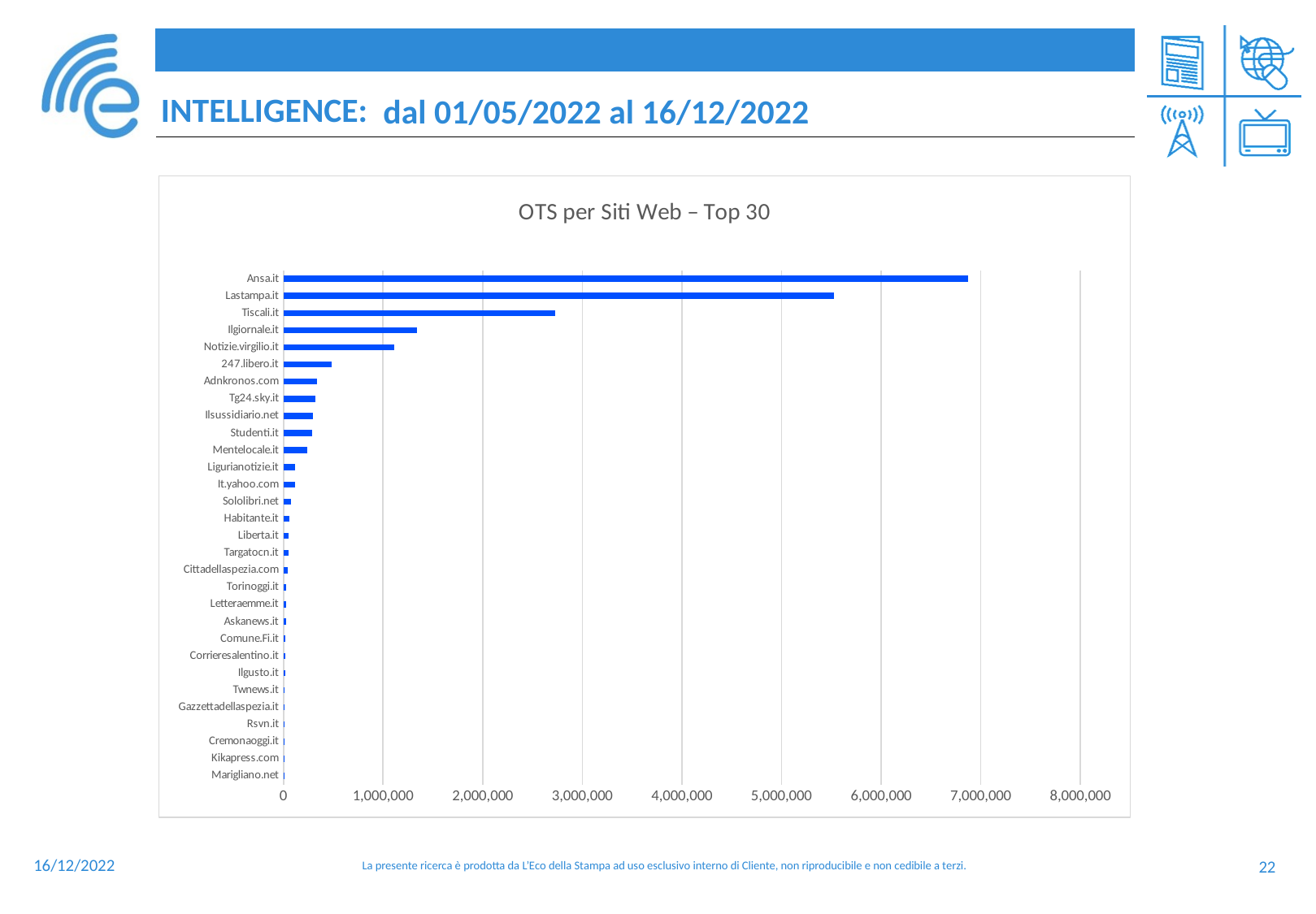
Is the value for Ansa.it greater or less than 6,000,000? greater Is the value for Tiscali.it greater or less than 3,000,000? less Which has a larger value, Ansa.it or Lastampa.it? Ansa.it Is the value for 247.libero.it greater or less than 1,000,000? less What kind of chart is shown on the slide? bar chart Which has a larger value, Tiscali.it or Ilgiornale.it? Tiscali.it How many websites are listed in the chart? 30 Do the bar values increase or decrease going from the top of the chart to the bottom? decrease Which website has the highest OTS value? Ansa.it What is the title of the chart? OTS per Siti Web – Top 30